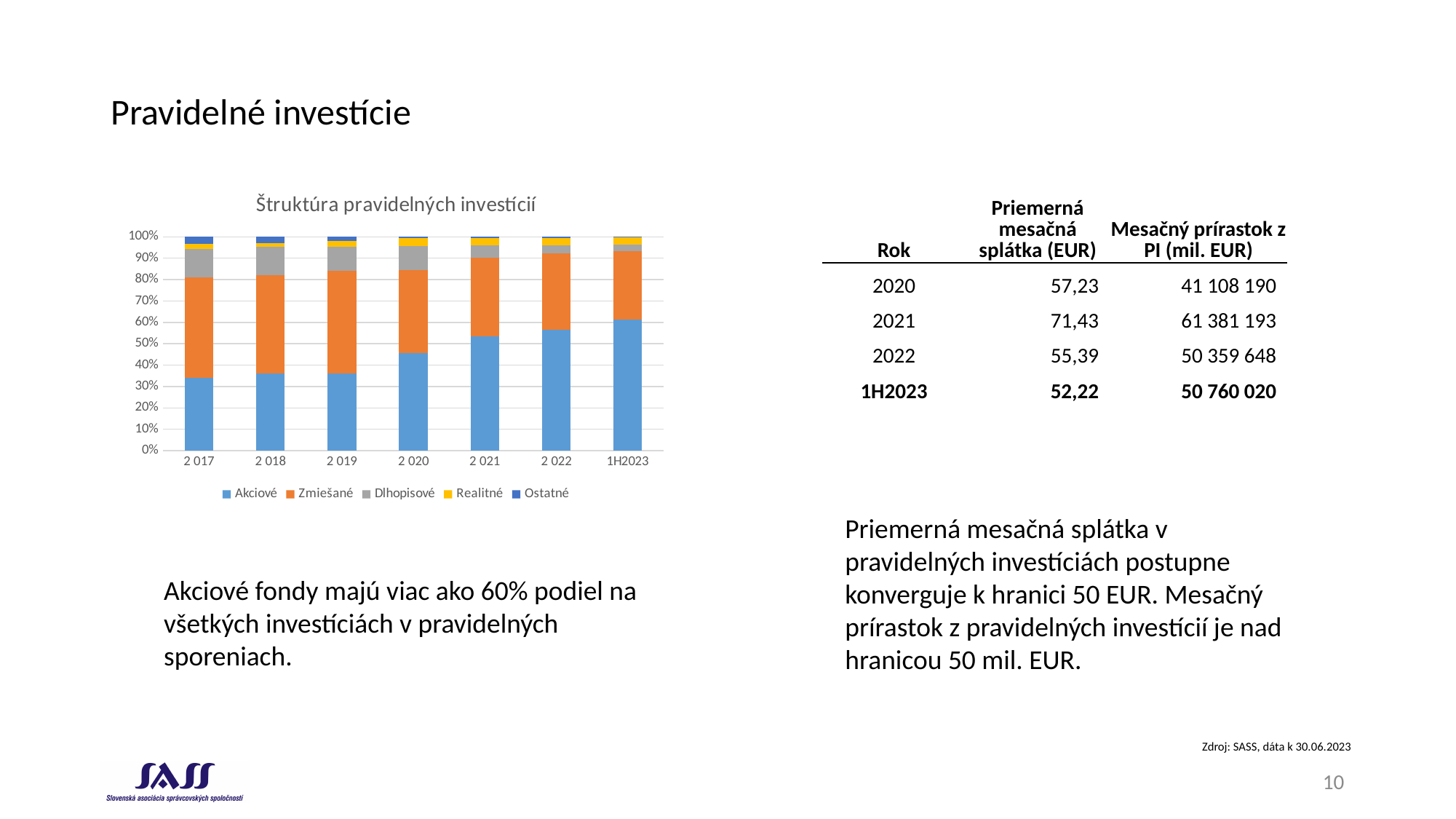
What kind of chart is shown on the slide? stacked bar chart Does the share of Akciové rise or fall from 2017 to 1H2023? rise How many series does the chart legend list? 5 Is the share of Akciové in 2020 greater or less than 50%? less What is the title of the chart? Štruktúra pravidelných investícií How many periods (bars) are shown on the x axis of the chart? 7 Which period has a larger share of Akciové, 2017 or 2022? 2022 Which series is shown in blue at the bottom of each bar? Akciové Is the share of Akciové in 1H2023 greater or less than 60%? greater In which period is the share of Akciové the highest? 1H2023 Is the share of Akciové in 2017 greater or less than 40%? less In which period is the share of Zmiešané the lowest? 1H2023